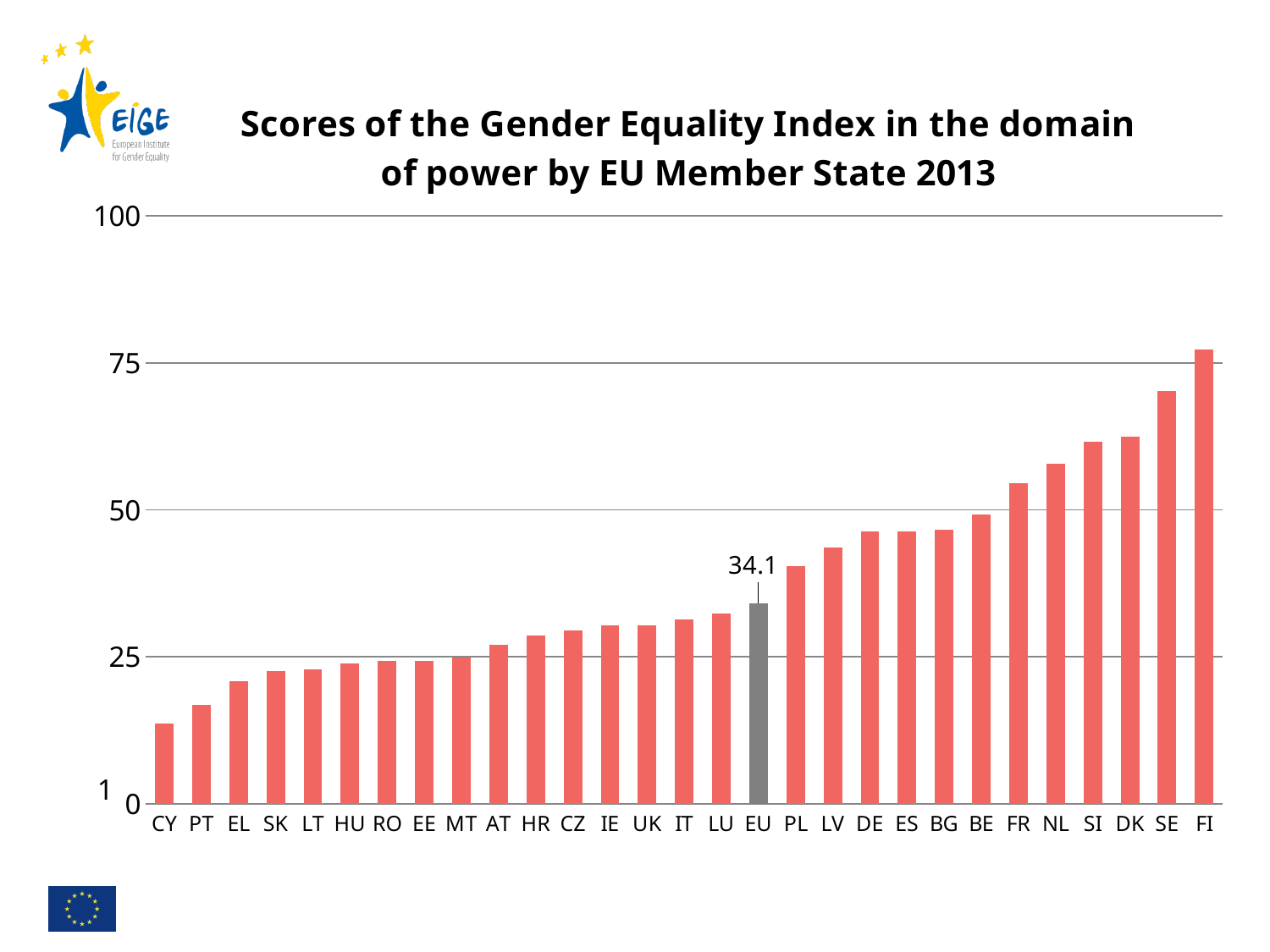
Which Member State has the highest score in the domain of power? FI Is the value for SE greater or less than 75? less Do the values rise or fall from left to right along the x axis? rise Is the value for FI greater or less than 75? greater Which bar is coloured differently (grey) from the others? EU Which has a higher score, PL or LU? PL Which Member State has the lowest score in the domain of power? CY What is the value shown for EU? 34.1 Is the value for FR greater or less than 50? greater What type of chart is shown on the slide? bar chart How many bars are plotted on the chart? 29